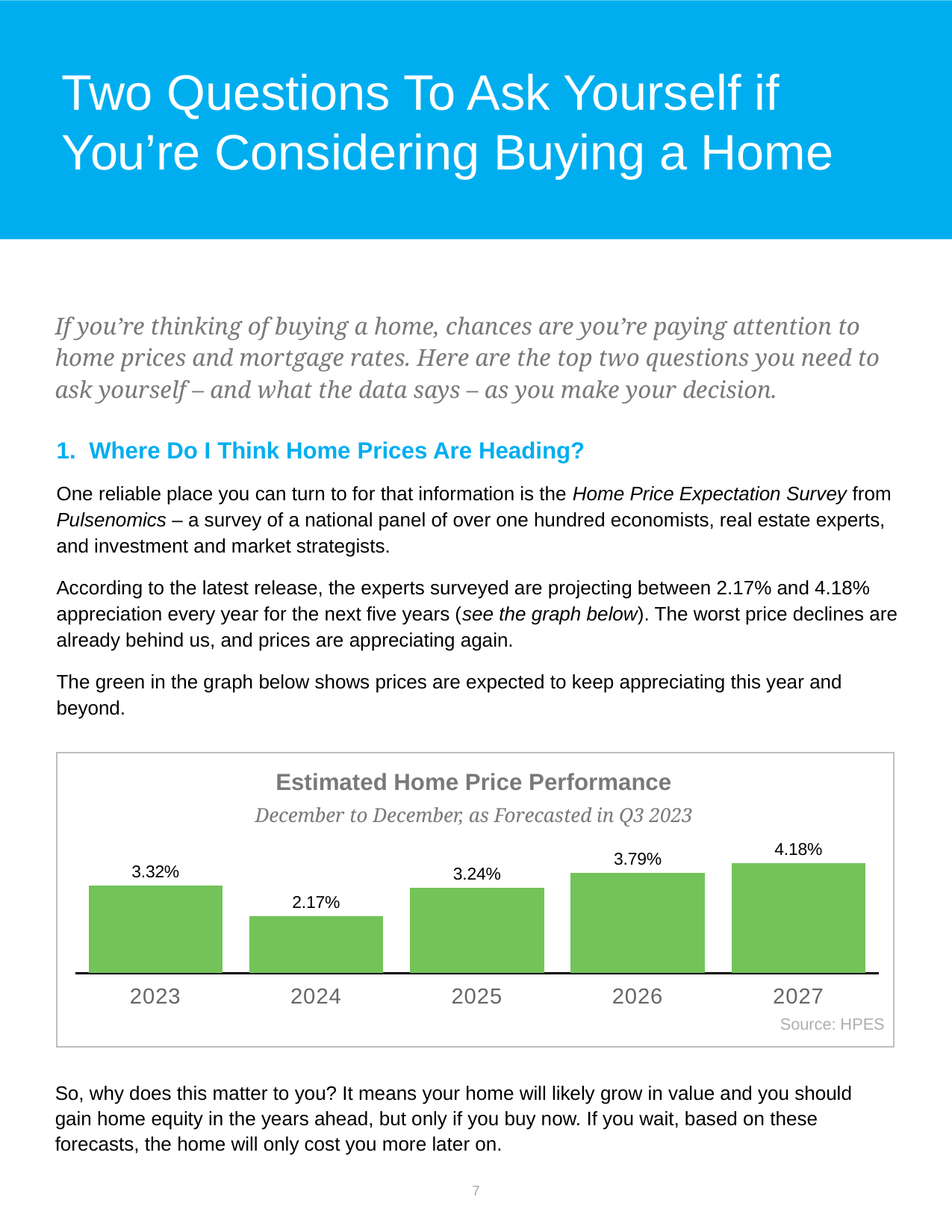
How many years are shown in the chart? 5 What kind of chart is shown on the slide? Bar chart What is the estimated home price performance for 2024? 2.17% What is the estimated home price performance for 2026? 3.79% Which year has the highest estimated home price performance? 2027 What is the title of the chart? Estimated Home Price Performance What source is cited for the chart? HPES What is the difference between the estimated home price performance for 2027 and 2024? 2.01% Do the estimated values rise or fall from 2024 to 2027? Rise What is the estimated home price performance for 2023? 3.32% Which year has a higher estimated home price performance, 2023 or 2025? 2023 Which year has the lowest estimated home price performance? 2024